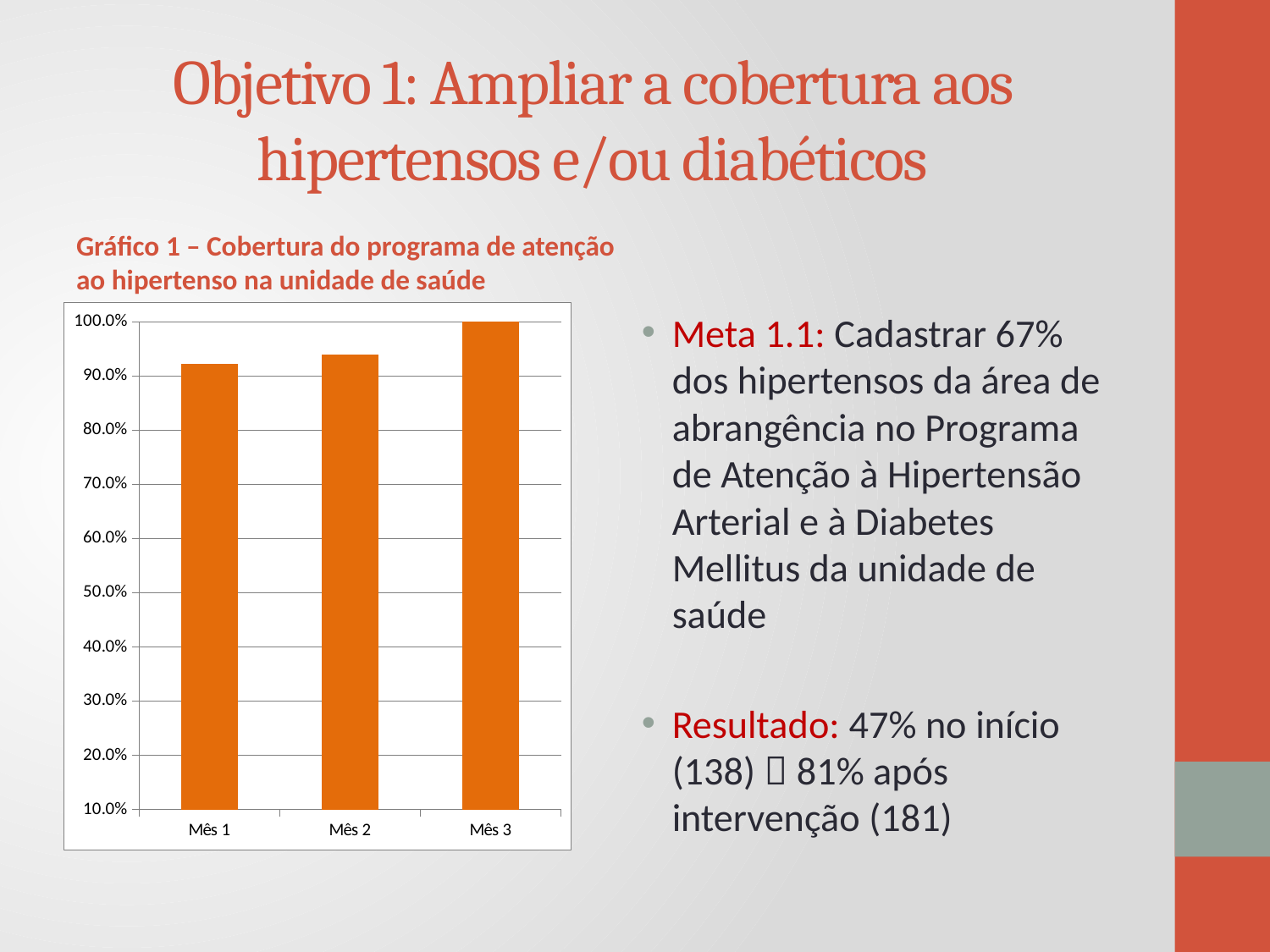
Is the value for Mês 2 greater or less than 90.0%? greater Is the value for Mês 1 greater or less than 80.0%? greater Is the value for Mês 1 greater or less than 100.0%? less How many categories (months) are plotted on the chart? 3 What is the title of the chart? Gráfico 1 – Cobertura do programa de atenção ao hipertenso na unidade de saúde Which month has the highest value on the chart? Mês 3 What colour are the bars in the chart? orange What kind of chart is shown on the slide? bar chart Do the values rise or fall from Mês 1 to Mês 3? rise What is the value for Mês 3 on the chart? 100.0% Which is larger, the value for Mês 1 or the value for Mês 3? Mês 3 What is the lowest value shown on the vertical axis of the chart? 10.0%